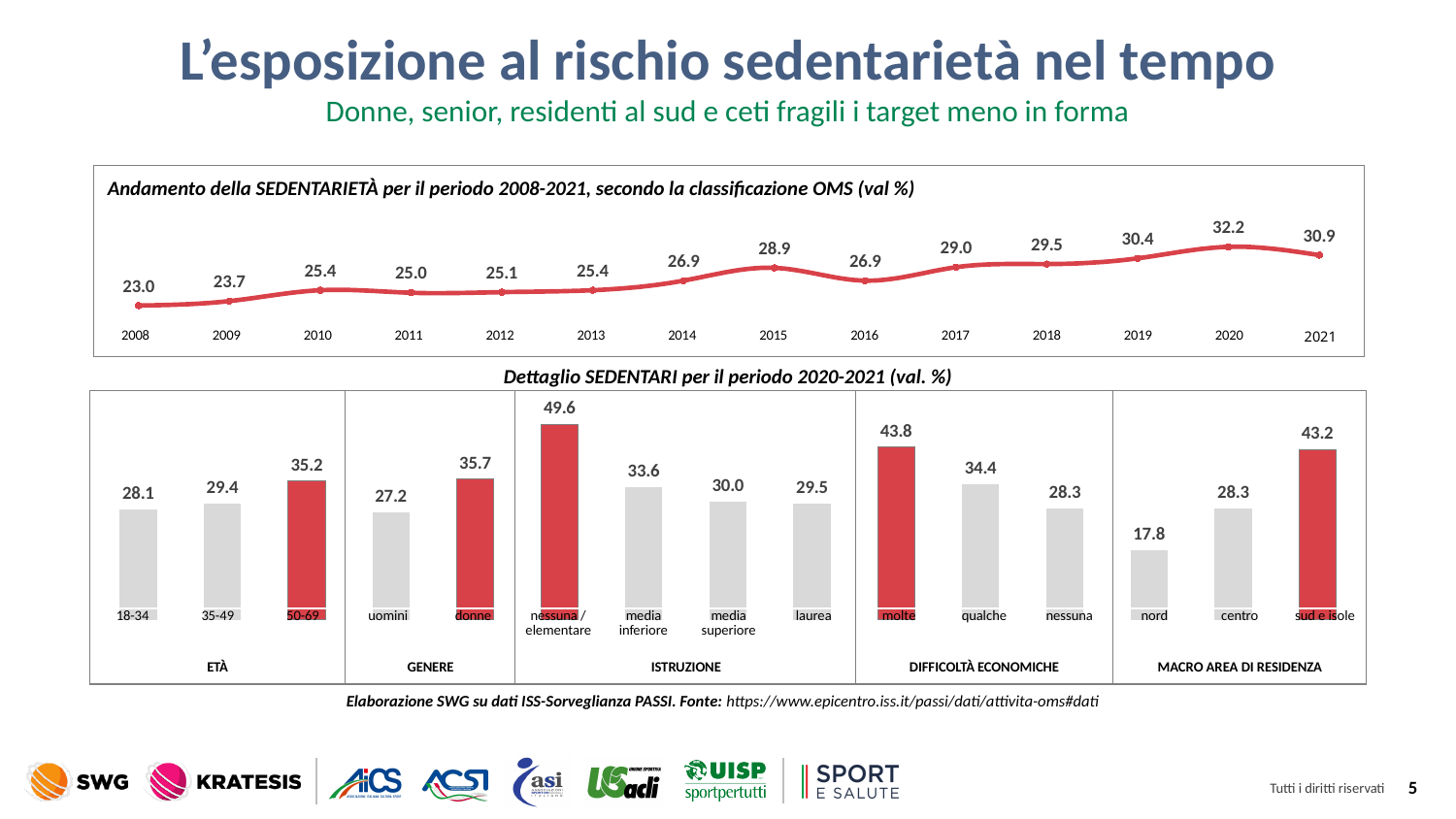
In the top chart 'Andamento della SEDENTARIETÀ per il periodo 2008-2021', which year has the highest value? 2020 In the bottom chart 'Dettaglio SEDENTARI per il periodo 2020-2021', what is the difference between the value for 'sud e isole' and the value for 'nord'? 25.4 What kind of chart is the top chart 'Andamento della SEDENTARIETÀ per il periodo 2008-2021'? Line chart In the top chart 'Andamento della SEDENTARIETÀ per il periodo 2008-2021', do the values generally rise or fall from 2008 to 2021? Rise In the top chart 'Andamento della SEDENTARIETÀ per il periodo 2008-2021', what is the value for 2008? 23.0 In the top chart 'Andamento della SEDENTARIETÀ per il periodo 2008-2021', what is the difference between the 2020 value and the 2008 value? 9.2 In the bottom chart 'Dettaglio SEDENTARI per il periodo 2020-2021', what is the value for 'nessuna / elementare' under ISTRUZIONE? 49.6 In the top chart 'Andamento della SEDENTARIETÀ per il periodo 2008-2021', which year has the lowest value? 2008 In the top chart 'Andamento della SEDENTARIETÀ per il periodo 2008-2021', what is the value for 2021? 30.9 In the bottom chart 'Dettaglio SEDENTARI per il periodo 2020-2021', which category has the lowest value? nord In the top chart 'Andamento della SEDENTARIETÀ per il periodo 2008-2021', how many years are plotted? 14 In the bottom chart 'Dettaglio SEDENTARI per il periodo 2020-2021', which is larger, the value for 'donne' or the value for 'uomini'? donne